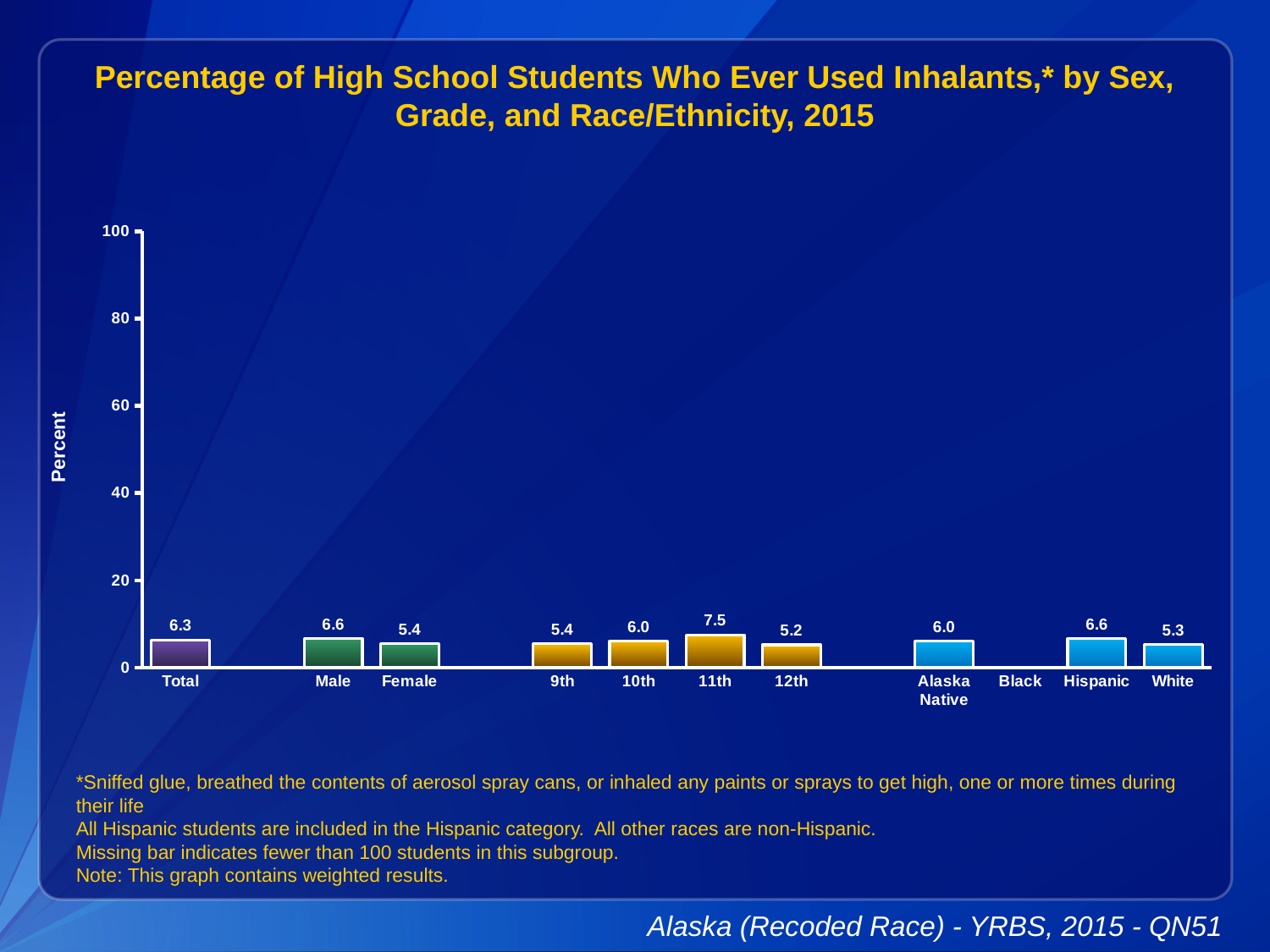
What is the value for 11th grade? 7.5 What is the label on the y axis? Percent Which is larger, the value for Hispanic or the value for White? Hispanic What is the value for Total? 6.3 What kind of chart is this? bar chart Which grade has the lowest value? 12th Is the value for 11th grade greater or less than 20? less Which category has the highest value? 11th What is the difference between the Male and Female values? 1.2 How many categories have a bar plotted? 10 What is the value for Alaska Native? 6.0 Which category label has no bar shown? Black